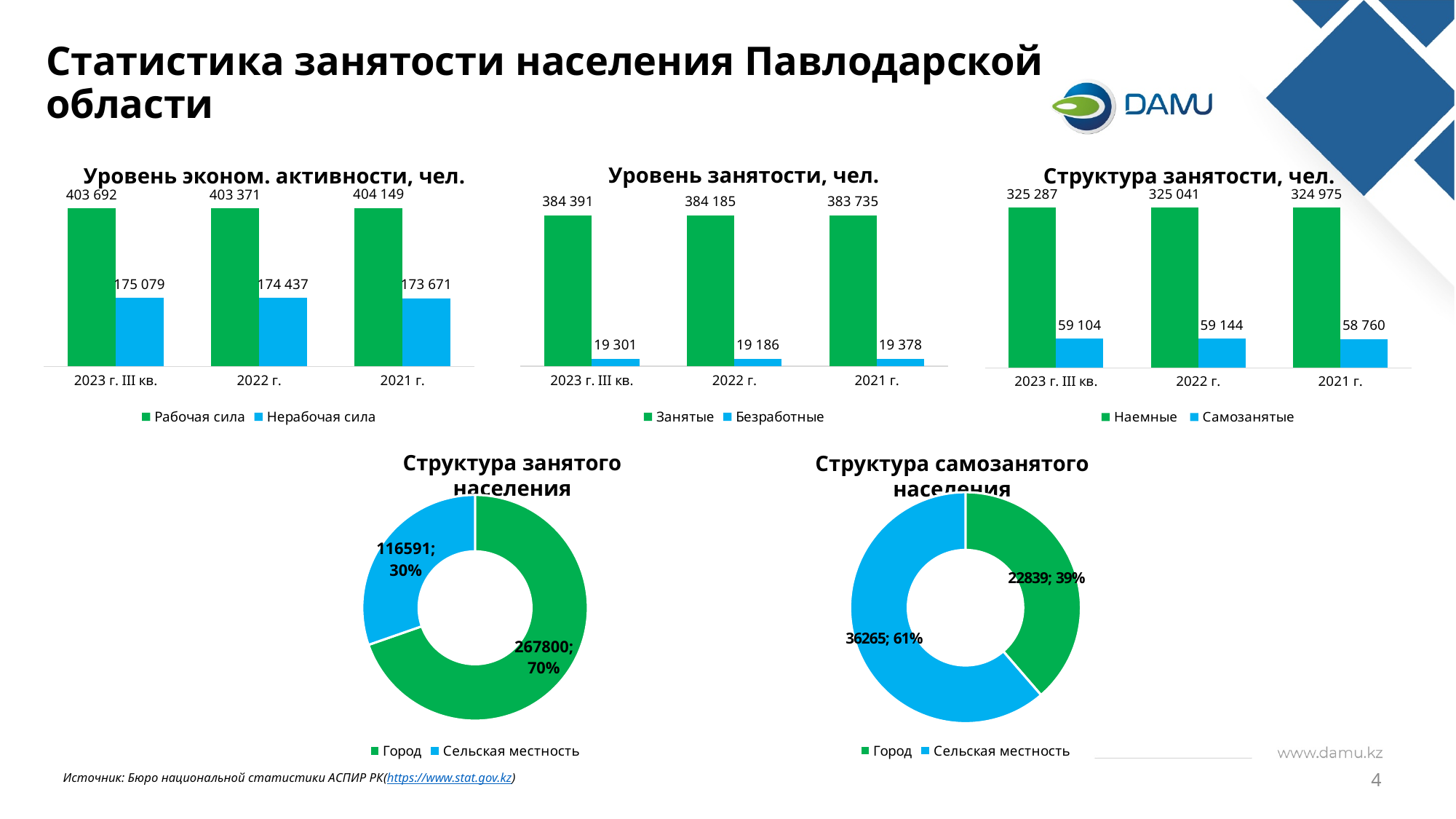
In the chart 'Структура занятости, чел.', what is the value of 'Самозанятые' for 2021 г.? 58 760 In the chart 'Уровень эконом. активности, чел.', what is the value of 'Нерабочая сила' for 2023 г. III кв.? 175 079 How many series does the legend of the chart 'Уровень занятости, чел.' list? 2 In the chart 'Структура занятости, чел.', what is the difference between 'Наемные' and 'Самозанятые' for 2023 г. III кв.? 266 183 What type of chart is 'Структура самозанятого населения'? Doughnut (pie) chart In the chart 'Уровень занятости, чел.', which period has the highest value of 'Занятые'? 2023 г. III кв. In the chart 'Структура занятого населения', what share does 'Сельская местность' have? 30% In the chart 'Структура занятости, чел.', which period has the lowest value of 'Самозанятые'? 2021 г. In the chart 'Структура занятого населения', what is the value for 'Город'? 267800 In the chart 'Структура самозанятого населения', which is larger: 'Город' or 'Сельская местность'? Сельская местность In the chart 'Уровень эконом. активности, чел.', what is the value of 'Рабочая сила' for 2021 г.? 404 149 In the chart 'Уровень занятости, чел.', what is the value of 'Безработные' for 2022 г.? 19 186